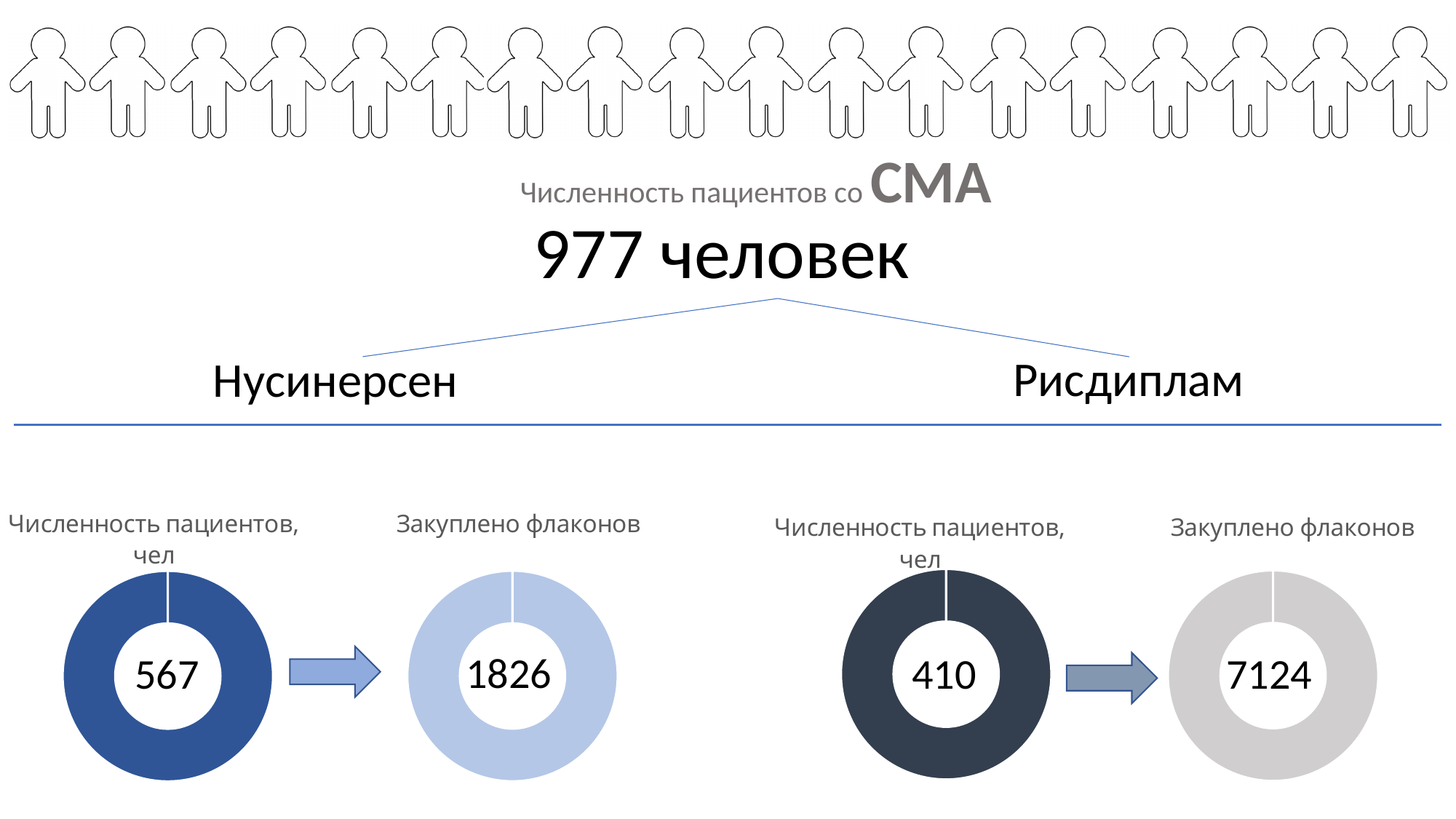
What kind of chart is used to display the four values at the bottom of the slide? Donut chart Which drug has more vials purchased according to the 'Закуплено флаконов' charts, Нусинерсен or Рисдиплам? Рисдиплам How many donut charts are shown on the slide? 4 Which drug has more patients according to the 'Численность пациентов, чел' charts, Нусинерсен or Рисдиплам? Нусинерсен What is the total number of patients with СМА stated on the slide? 977 человек On the Рисдиплам 'Численность пациентов, чел' donut chart, what value is shown in the centre? 410 What is the difference between the vials purchased for Рисдиплам (7124) and for Нусинерсен (1826)? 5298 On the Рисдиплам 'Закуплено флаконов' donut chart, what value is shown in the centre? 7124 What is the difference between the number of patients on Нусинерсен (567) and on Рисдиплам (410)? 157 On the Нусинерсен 'Закуплено флаконов' donut chart, what value is shown in the centre? 1826 What is the title of the leftmost donut chart on the slide? Численность пациентов, чел On the Нусинерсен 'Численность пациентов, чел' donut chart, what value is shown in the centre? 567